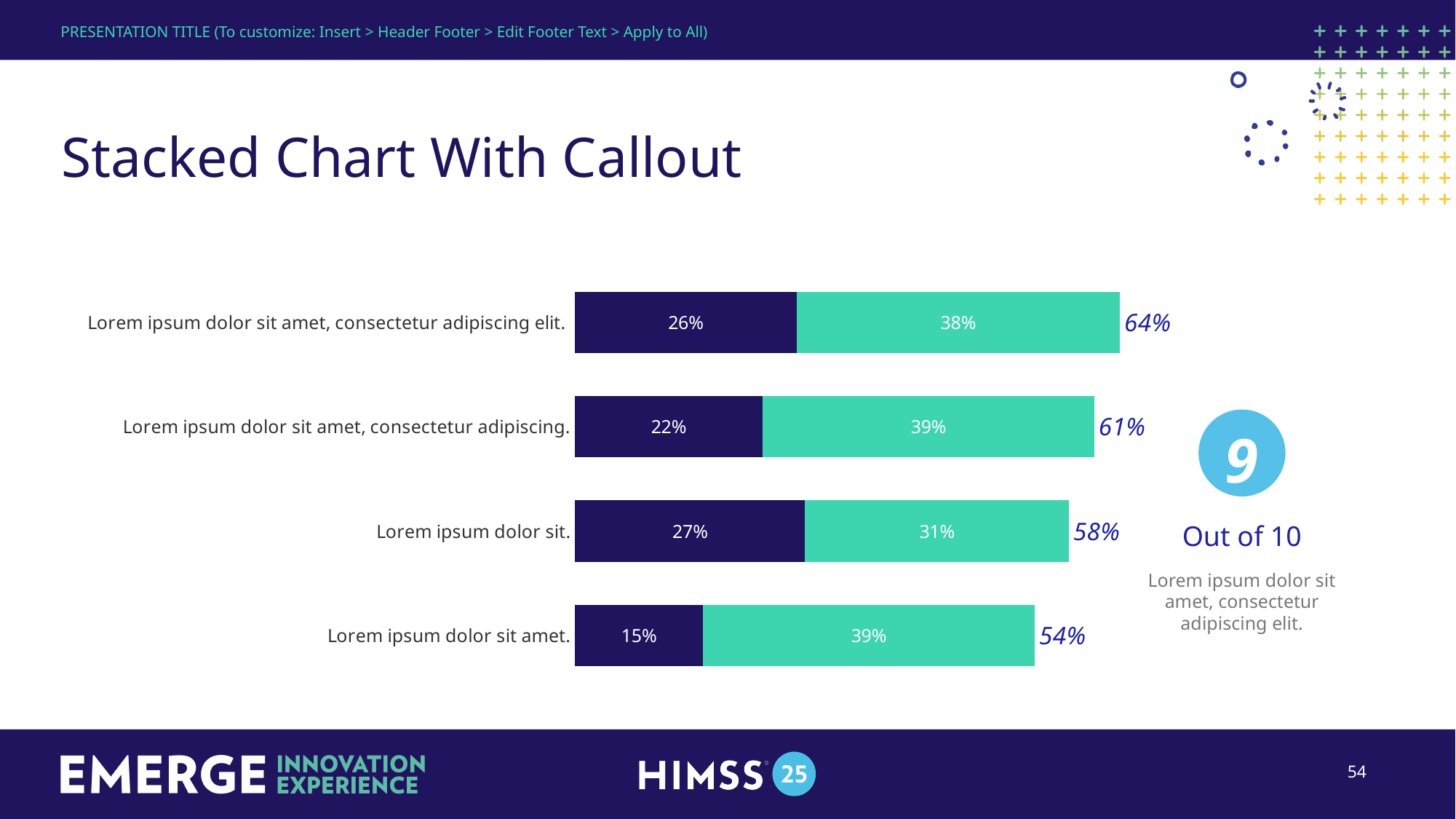
What number is shown in the blue circle callout next to the chart? 9 What is the value of the dark navy segment in the top bar, labelled "Lorem ipsum dolor sit amet, consectetur adipiscing elit."? 26% What is the total shown for the bottom bar, labelled "Lorem ipsum dolor sit amet."? 54% How many bars (categories) does the chart show? 4 What is the total shown for the bar labelled "Lorem ipsum dolor sit amet, consectetur adipiscing."? 61% Which bar has the highest total? Lorem ipsum dolor sit amet, consectetur adipiscing elit. (64%) Do the bar totals rise or fall from the top bar to the bottom bar? Fall What is the difference between the totals of the top bar (64%) and the bottom bar (54%)? 10% Which is larger: the dark navy segment of the bar labelled "Lorem ipsum dolor sit." or the dark navy segment of the bar labelled "Lorem ipsum dolor sit amet, consectetur adipiscing."? Lorem ipsum dolor sit. (27%) What is the value of the teal segment in the bar labelled "Lorem ipsum dolor sit."? 31% Which bar has the smallest dark navy segment? Lorem ipsum dolor sit amet. (15%) What kind of chart is shown on the slide? Stacked bar chart